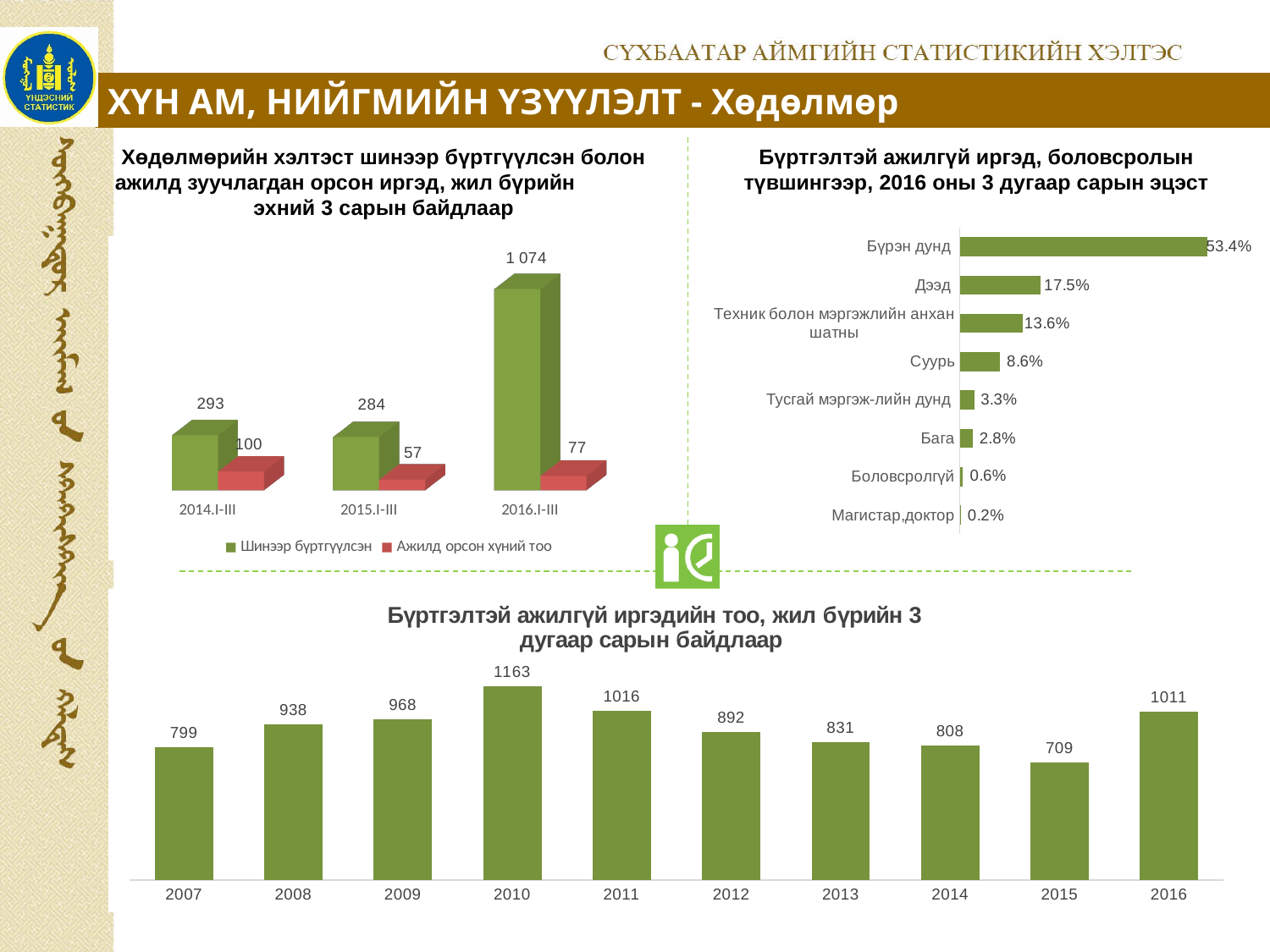
In the top-right chart (Бүртгэлтэй ажилгүй иргэд, боловсролын түвшингээр), what is the value for Дээд? 17.5% What kind of chart is the top-right chart (Бүртгэлтэй ажилгүй иргэд, боловсролын түвшингээр)? Horizontal bar chart In the top-left chart (Хөдөлмөрийн хэлтэст шинээр бүртгүүлсэн...), what is the difference between Ажилд орсон хүний тоо for 2014.I-III and 2015.I-III? 43 In the top-right chart (Бүртгэлтэй ажилгүй иргэд, боловсролын түвшингээр), which category has the highest value? Бүрэн дунд In the bottom chart (Бүртгэлтэй ажилгүй иргэдийн тоо), which year has the lowest value? 2015 In the top-right chart (Бүртгэлтэй ажилгүй иргэд, боловсролын түвшингээр), how many education categories are listed? 8 In the top-left chart (Хөдөлмөрийн хэлтэст шинээр бүртгүүлсэн...), what is the value of Шинээр бүртгүүлсэн for 2016.I-III? 1 074 In the top-left chart (Хөдөлмөрийн хэлтэст шинээр бүртгүүлсэн...), how many series does the legend list? 2 In the bottom chart (Бүртгэлтэй ажилгүй иргэдийн тоо), what is the value for 2010? 1163 In the bottom chart (Бүртгэлтэй ажилгүй иргэдийн тоо), is the value for 2008 larger or smaller than the value for 2012? larger In the bottom chart (Бүртгэлтэй ажилгүй иргэдийн тоо), how many years are shown on the x axis? 10 In the bottom chart (Бүртгэлтэй ажилгүй иргэдийн тоо), what is the difference between the values for 2016 and 2015? 302